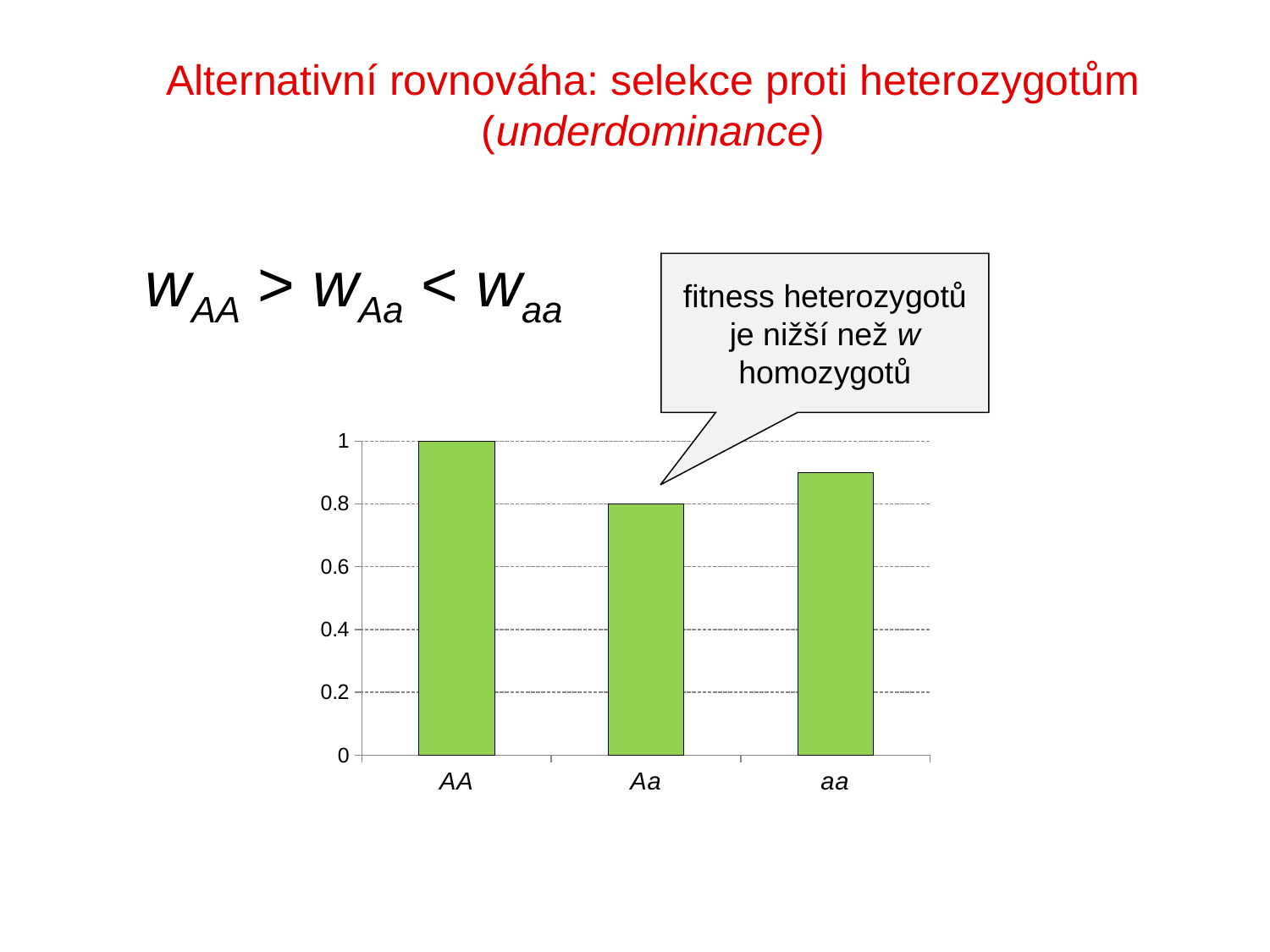
What colour are the bars in the chart? green Which category has the highest value? AA Is the value for aa greater or less than 1? less How many categories are shown on the x axis? 3 Which category has the lowest value? Aa What kind of chart is shown on the slide? bar chart What is the value for AA? 1 Which is larger, the value for AA or the value for aa? AA Is the value for aa greater or less than 0.8? greater What is the difference between the values for AA and Aa? 0.2